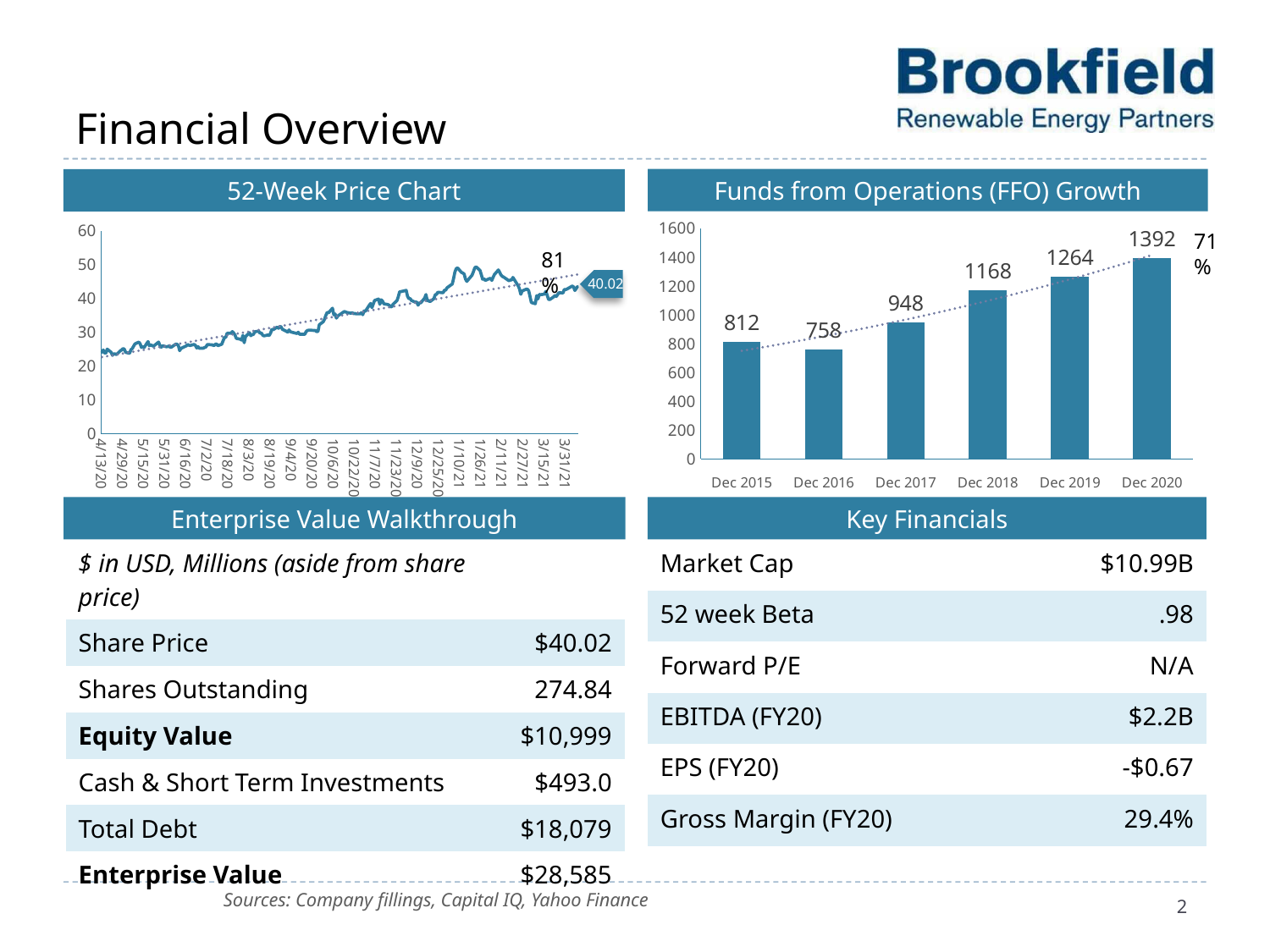
On the Funds from Operations (FFO) Growth chart, which year has the highest value? Dec 2020 On the Funds from Operations (FFO) Growth chart, what is the value for Dec 2016? 758 On the Funds from Operations (FFO) Growth chart, what is the difference between the Dec 2020 and Dec 2015 values? 580 What kind of chart is the Funds from Operations (FFO) Growth chart? Bar chart On the Funds from Operations (FFO) Growth chart, which year has the lowest value? Dec 2016 On the Funds from Operations (FFO) Growth chart, which is larger, the value for Dec 2017 or Dec 2019? Dec 2019 On the Funds from Operations (FFO) Growth chart, what is the value for Dec 2018? 1168 What kind of chart is the 52-Week Price Chart? Line chart How many bars are shown on the Funds from Operations (FFO) Growth chart? 6 On the 52-Week Price Chart, is the value at 4/13/20 greater or less than 30? less On the Funds from Operations (FFO) Growth chart, what percentage growth is annotated next to the Dec 2020 bar? 71% On the 52-Week Price Chart, what is the final labeled price value at the end of the line? 40.02